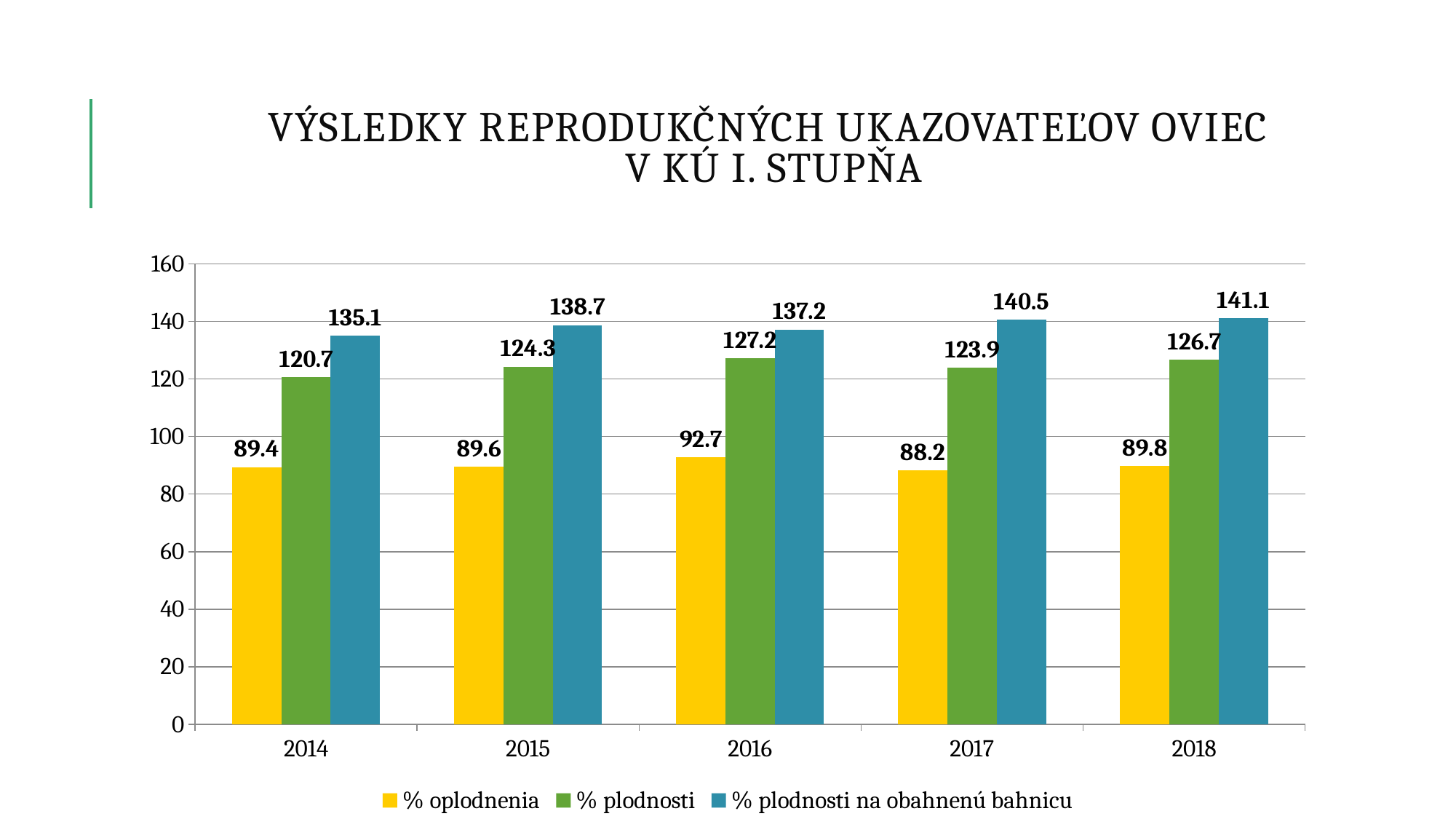
Which year has the lowest value for % oplodnenia? 2017 Does % plodnosti na obahnenú bahnicu rise or fall from 2017 to 2018? Rise What is the value of % oplodnenia for 2016? 92.7 What is the value of % plodnosti for 2014? 120.7 What kind of chart is shown on the slide? Bar chart Which is larger, % plodnosti in 2016 or % plodnosti in 2018? % plodnosti in 2016 Which colour represents % oplodnenia in the legend? Yellow What is the value of % plodnosti na obahnenú bahnicu for 2018? 141.1 Which year has the highest value for % plodnosti na obahnenú bahnicu? 2018 How many series does the legend list? 3 How many years are shown on the x axis? 5 What is the difference between % plodnosti na obahnenú bahnicu and % plodnosti in 2017? 16.6